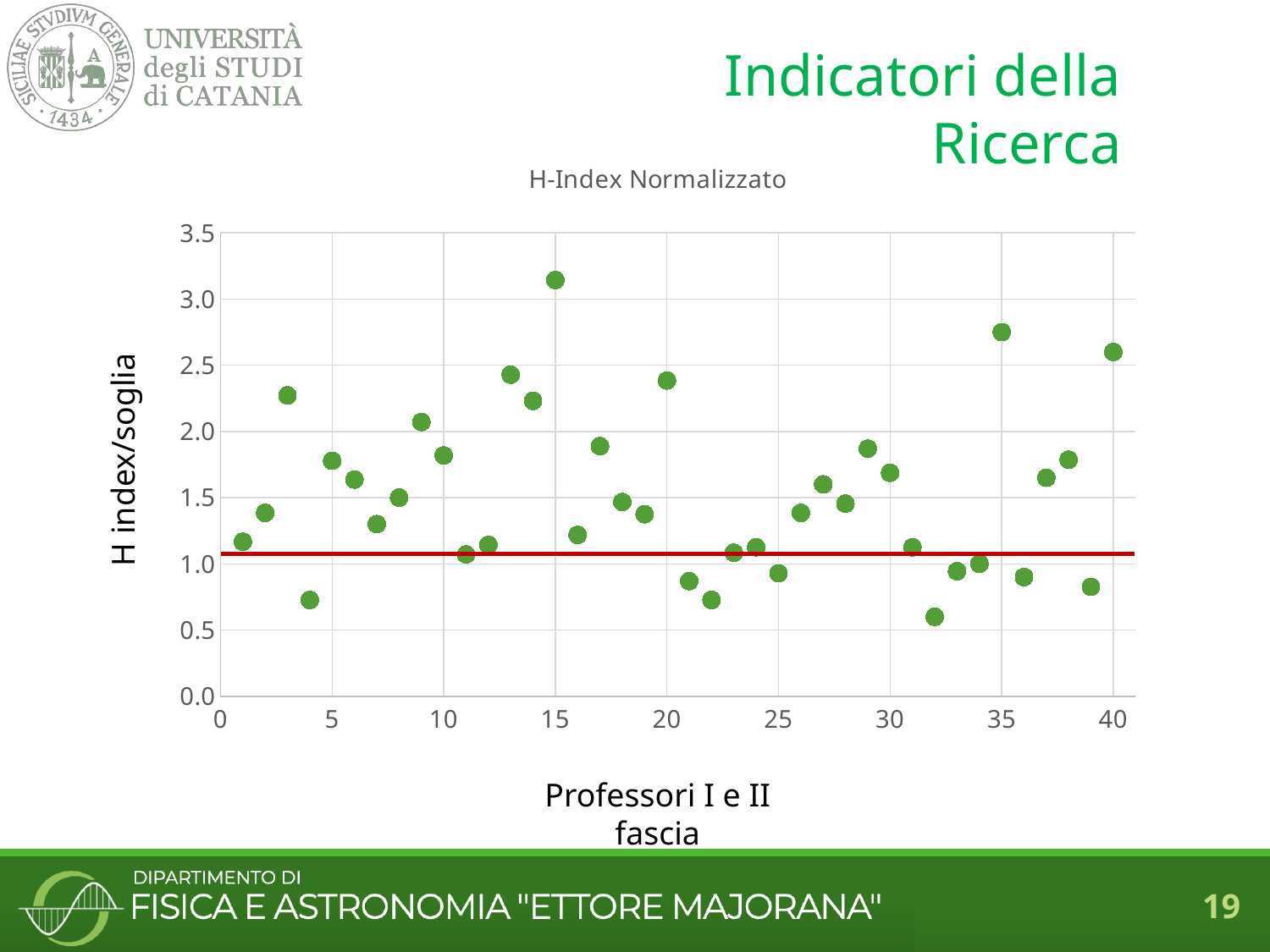
At which x value (professor number) is the highest point plotted? 15 Which has the larger value, professor 3 or professor 4? professor 3 What is the title of the chart? H-Index Normalizzato Is the value for professor 4 greater or less than 1.0? less What is the label of the vertical axis? H index/soglia Is the value for professor 35 greater or less than 2.5? greater Is the value for professor 13 greater or less than 2.0? greater What kind of chart is shown on the slide? scatter chart How many data points are plotted in the chart? 40 At which x value (professor number) is the lowest point plotted? 32